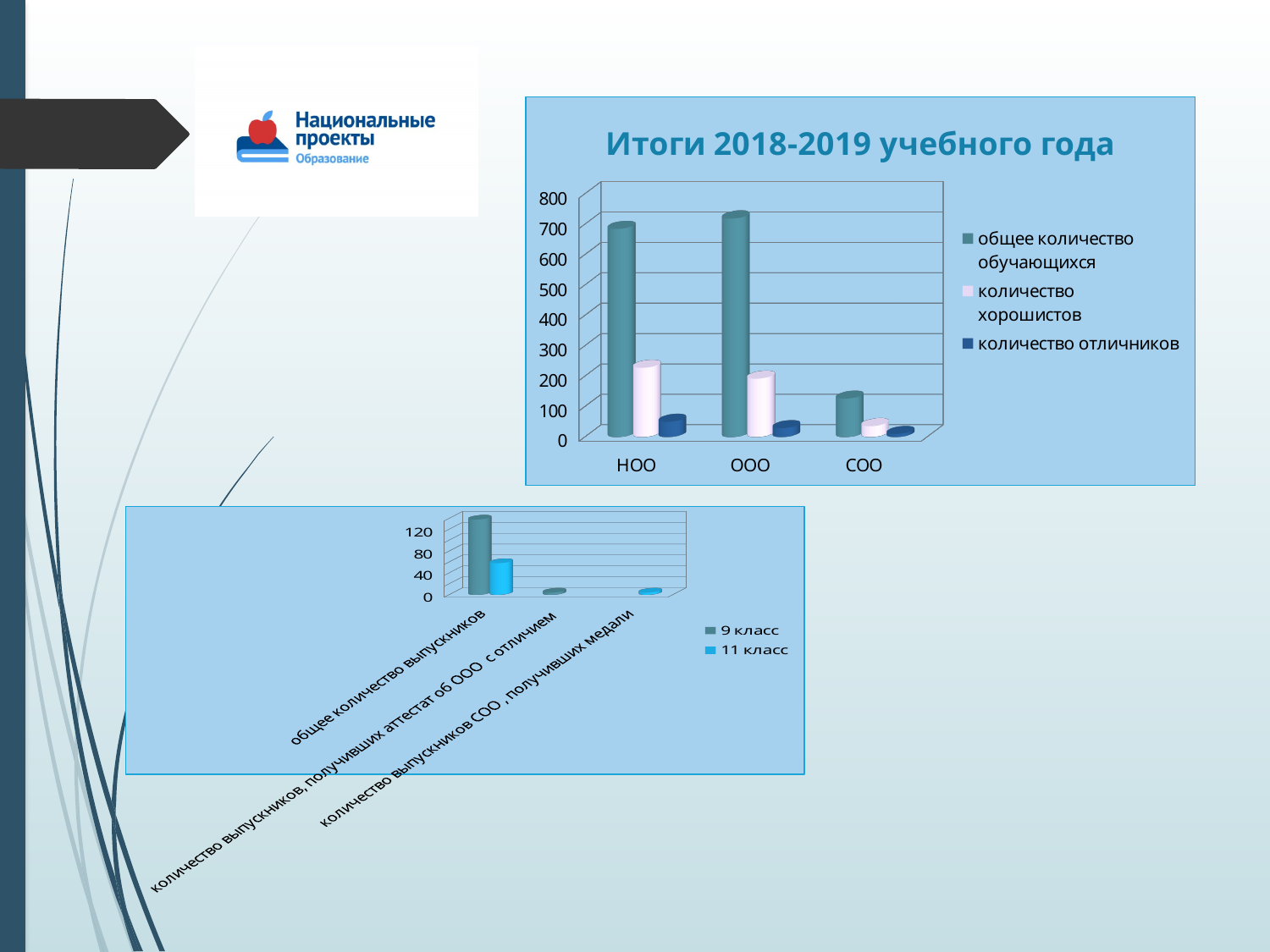
In the chart titled 'Итоги 2018-2019 учебного года', which is larger for ООО: 'количество хорошистов' or 'количество отличников'? количество хорошистов In the chart titled 'Итоги 2018-2019 учебного года', is the value of 'общее количество обучающихся' for НОО greater or less than 600? greater How many categories are shown on the x axis of the chart titled 'Итоги 2018-2019 учебного года'? 3 In the chart at the bottom left of the slide, which series has the larger value for 'общее количество выпускников': '9 класс' or '11 класс'? 9 класс What is the title of the chart at the top right of the slide? Итоги 2018-2019 учебного года In the chart at the bottom left of the slide, is the value of '9 класс' for 'общее количество выпускников' greater or less than 120? greater In the chart titled 'Итоги 2018-2019 учебного года', is the value of 'общее количество обучающихся' for СОО greater or less than 200? less How many series does the legend of the chart at the bottom left of the slide list? 2 How many series does the legend of the chart titled 'Итоги 2018-2019 учебного года' list? 3 What kind of chart is the chart titled 'Итоги 2018-2019 учебного года'? bar chart In the chart titled 'Итоги 2018-2019 учебного года', which category has the lowest value for 'общее количество обучающихся'? СОО